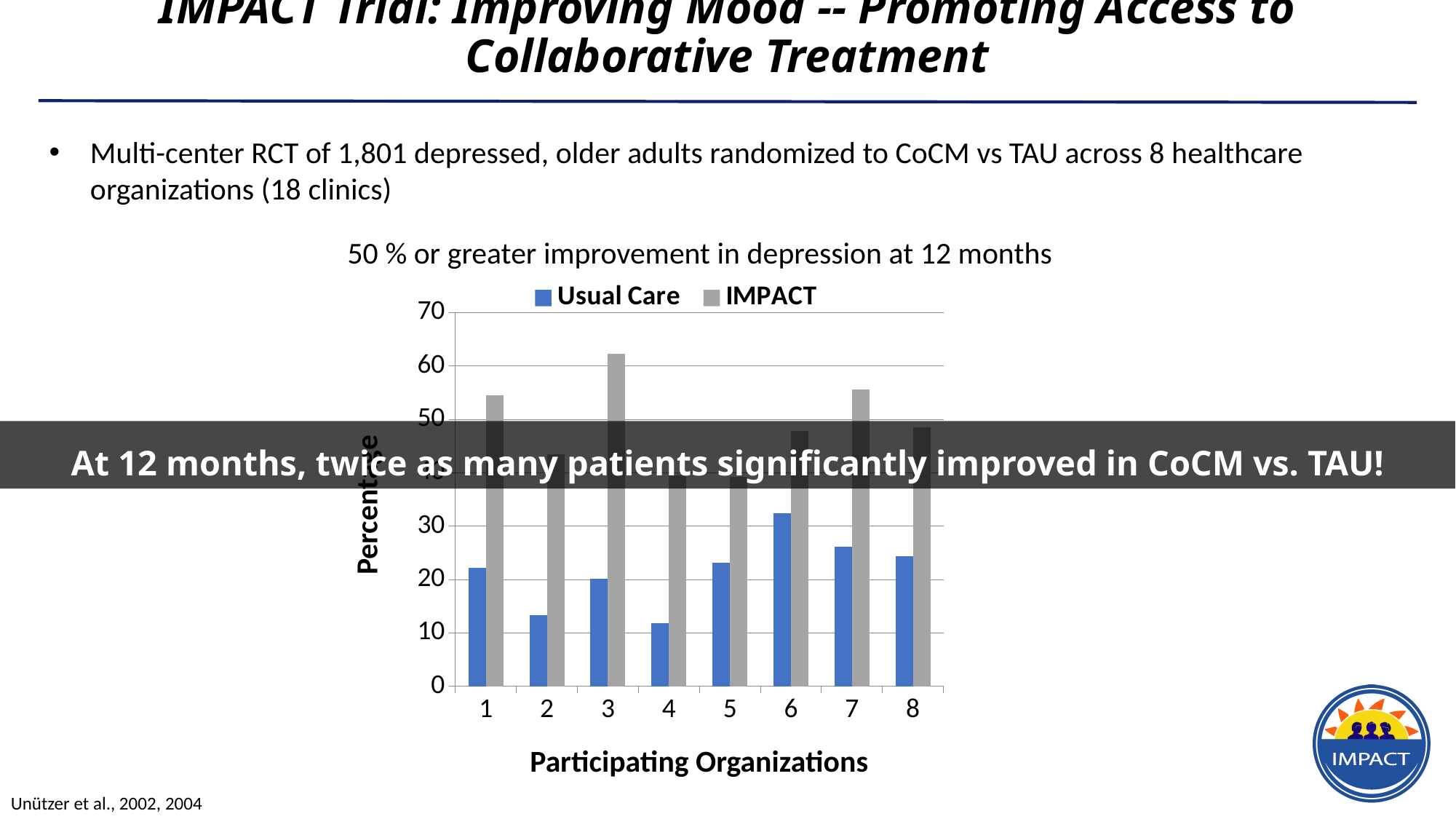
Is the Usual Care value for organization 2 greater or less than 20? less Is the IMPACT value for organization 1 greater or less than 50? greater For organization 1, which is larger: the Usual Care value or the IMPACT value? IMPACT Is the Usual Care value for organization 6 greater or less than 30? greater How many participating organizations are shown on the x axis? 8 What kind of chart is shown on the slide? bar chart Which participating organization has the highest Usual Care value? 6 Which participating organization has the highest IMPACT value? 3 What is the label of the x axis? Participating Organizations What is the title of the chart? 50 % or greater improvement in depression at 12 months How many series does the chart legend list? 2